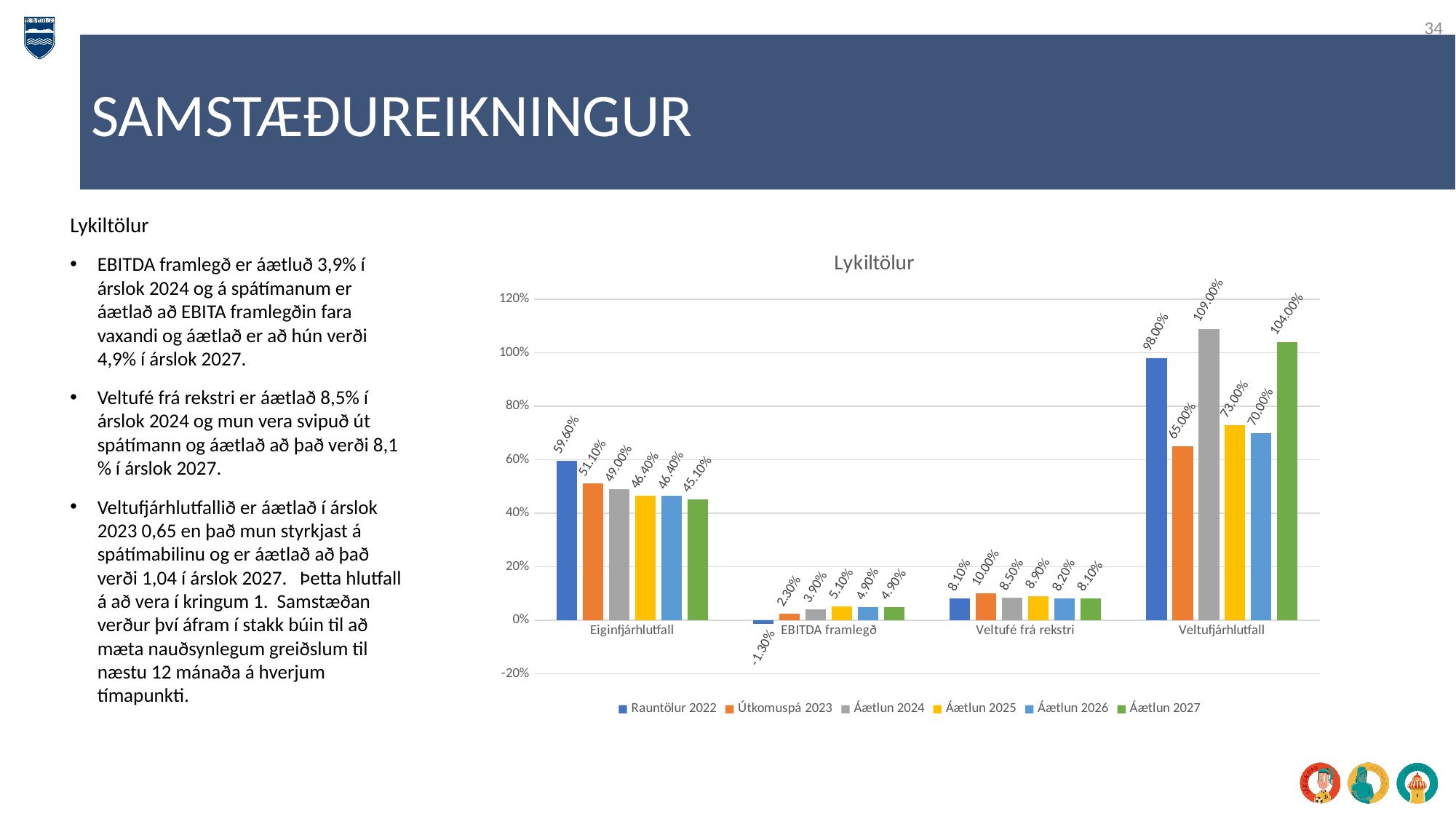
How many series does the chart legend list? 6 What is the title of the chart? Lykiltölur Which series has the lowest value for Eiginfjárhlutfall? Áætlun 2027 What is the difference between the Áætlun 2027 and Rauntölur 2022 values for Veltufjárhlutfall? 6.00% Which is larger for Veltufjárhlutfall: the Útkomuspá 2023 value or the Áætlun 2025 value? Áætlun 2025 What is the Áætlun 2024 value for Veltufjárhlutfall? 109.00% What is the Rauntölur 2022 value for EBITDA framlegð? -1.30% How many categories are shown on the x axis of the chart? 4 What is the Rauntölur 2022 value for Eiginfjárhlutfall? 59.60% Which series has the highest value for Veltufé frá rekstri? Útkomuspá 2023 What type of chart is shown on the slide? bar chart Do the Eiginfjárhlutfall values rise or fall from Rauntölur 2022 to Áætlun 2027? fall